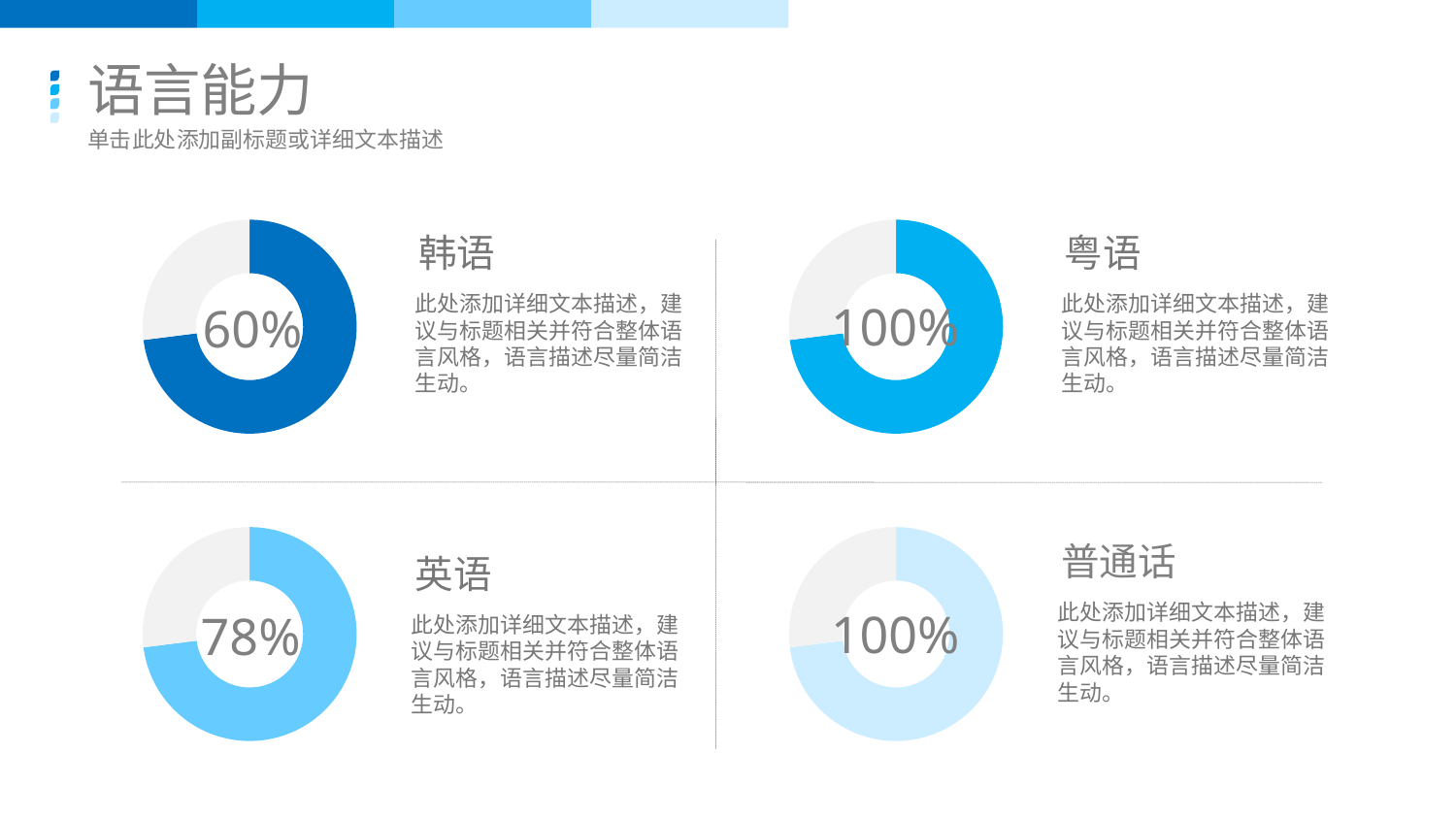
Which language has the lowest percentage among the four donut charts? 韩语 What percentage is shown in the 英语 donut chart? 78% Which is larger, the percentage for 粤语 or the percentage for 英语? 粤语 What percentage is shown in the 韩语 donut chart? 60% What percentage is shown in the 粤语 donut chart? 100% What is the difference between the 英语 percentage and the 韩语 percentage? 18% What kind of chart is used for each language on the slide? Donut (pie) chart How many donut charts are on the slide? 4 What percentage is shown in the 普通话 donut chart? 100% Which language's donut chart is in the bottom-right position of the slide? 普通话 Which is larger, the percentage for 英语 or the percentage for 韩语? 英语 What is the title of the slide containing the donut charts? 语言能力